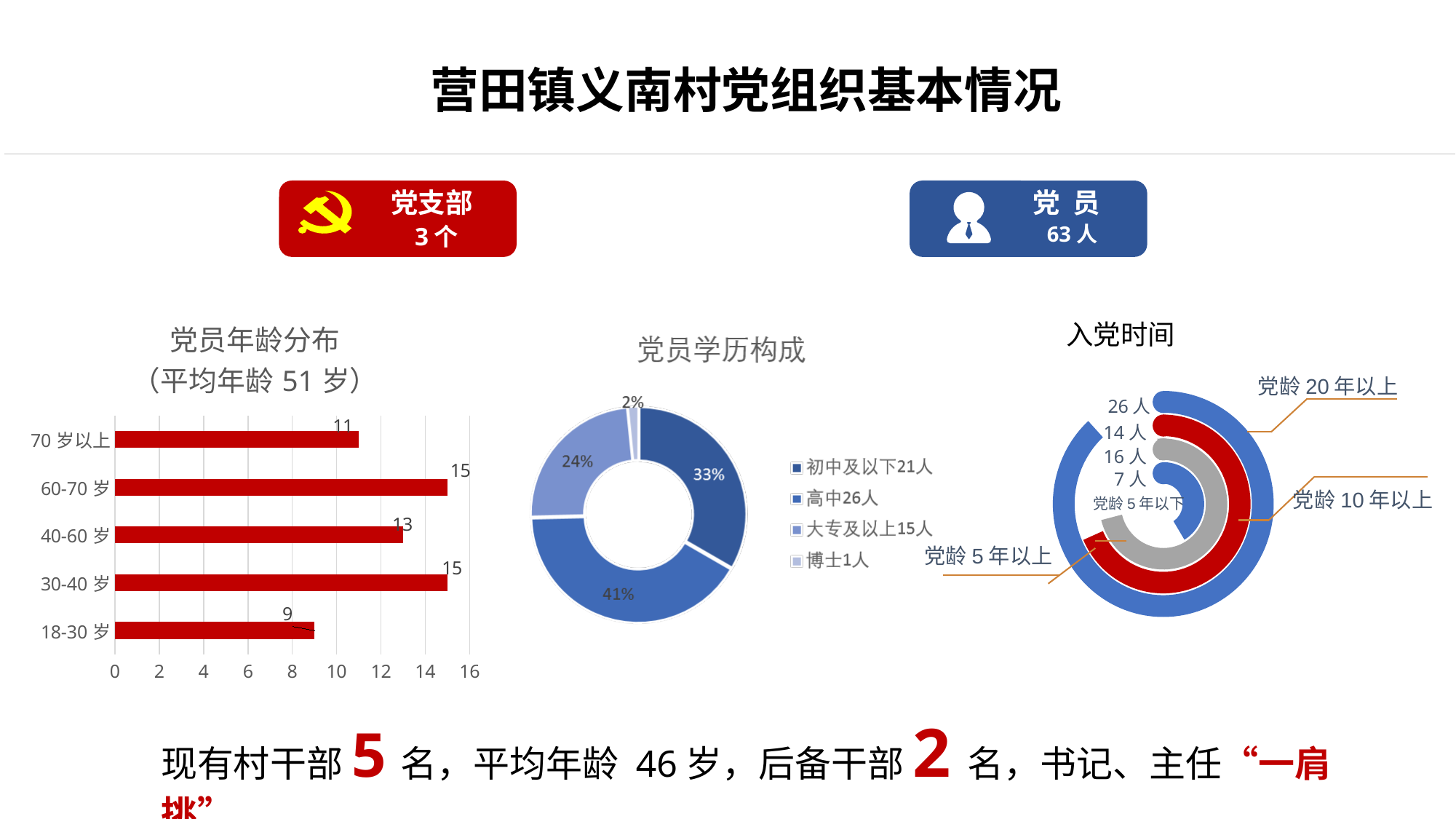
In the 入党时间 chart, how many people have 党龄 20 年以上? 26 人 In the 党员学历构成 chart, which category has the smallest share? 博士 In the 党员年龄分布 chart, what is the value for 70 岁以上? 11 In the 党员学历构成 chart, what share does 高中 have? 41% In the 党员年龄分布 chart, which is larger, the value for 40-60 岁 or the value for 70 岁以上? 40-60 岁 How many age groups are shown in the 党员年龄分布 chart? 5 How many categories does the legend of the 党员学历构成 chart list? 4 In the 党员年龄分布 chart, what is the value for 18-30 岁? 9 In the 党员年龄分布 chart, what is the difference between the values for 40-60 岁 and 18-30 岁? 4 What kind of chart is the 党员年龄分布 chart? bar chart In the 入党时间 chart, which category has the fewest people? 党龄 5 年以下 In the 党员年龄分布 chart, which age group has the lowest value? 18-30 岁